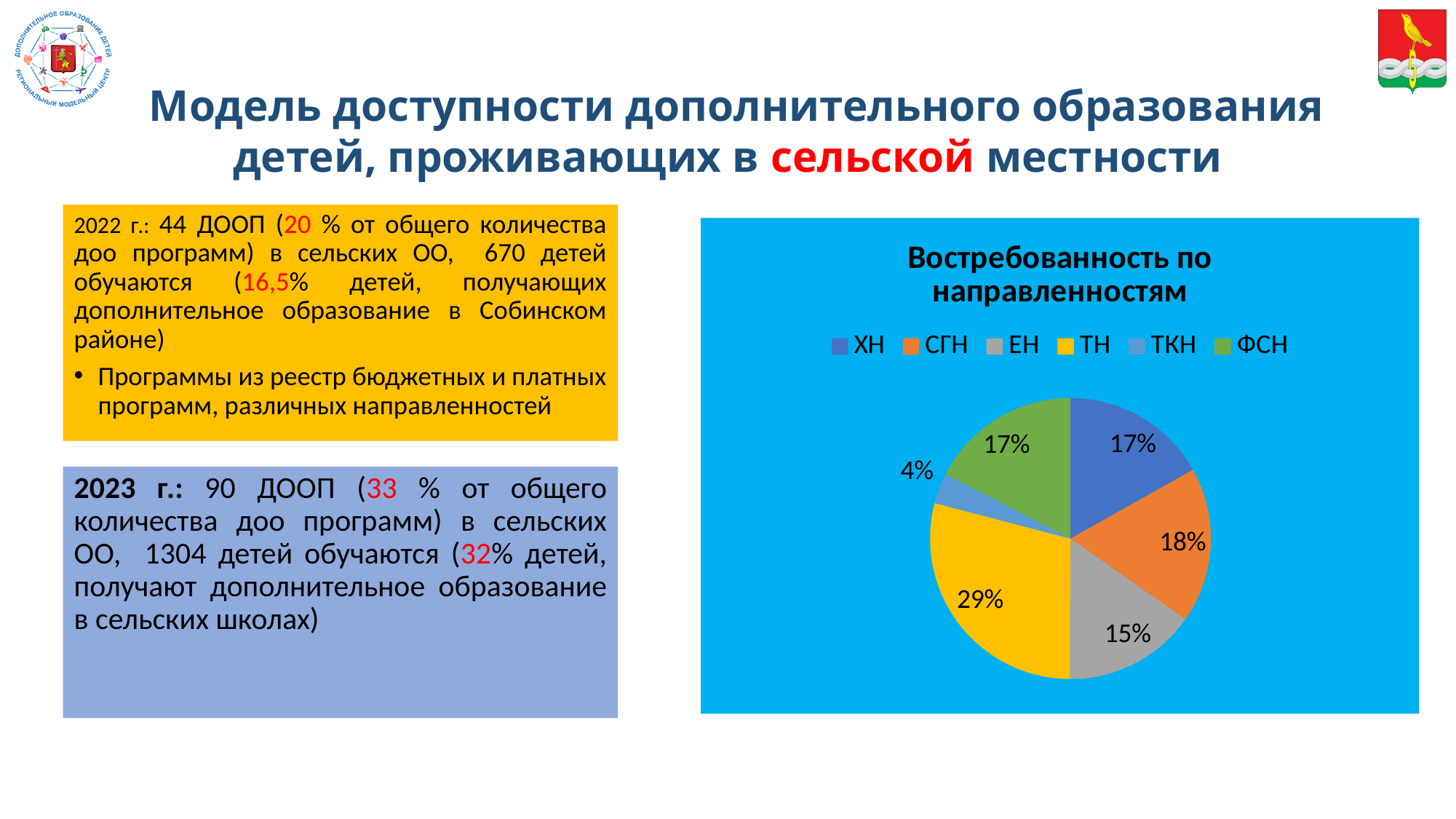
What share of the pie does СГН have? 18% What share of the pie does ТКН have? 4% What share of the pie does ЕН have? 15% Which category has the smallest slice of the pie? ТКН What is the difference between the shares of ТН and ЕН? 14% Which is larger, the share of СГН or the share of ЕН? СГН Which colour represents ФСН in the pie chart? green What is the title of the chart? Востребованность по направленностям Which category has the largest slice of the pie? ТН What kind of chart is shown on the slide? pie chart How many categories does the legend of the pie chart list? 6